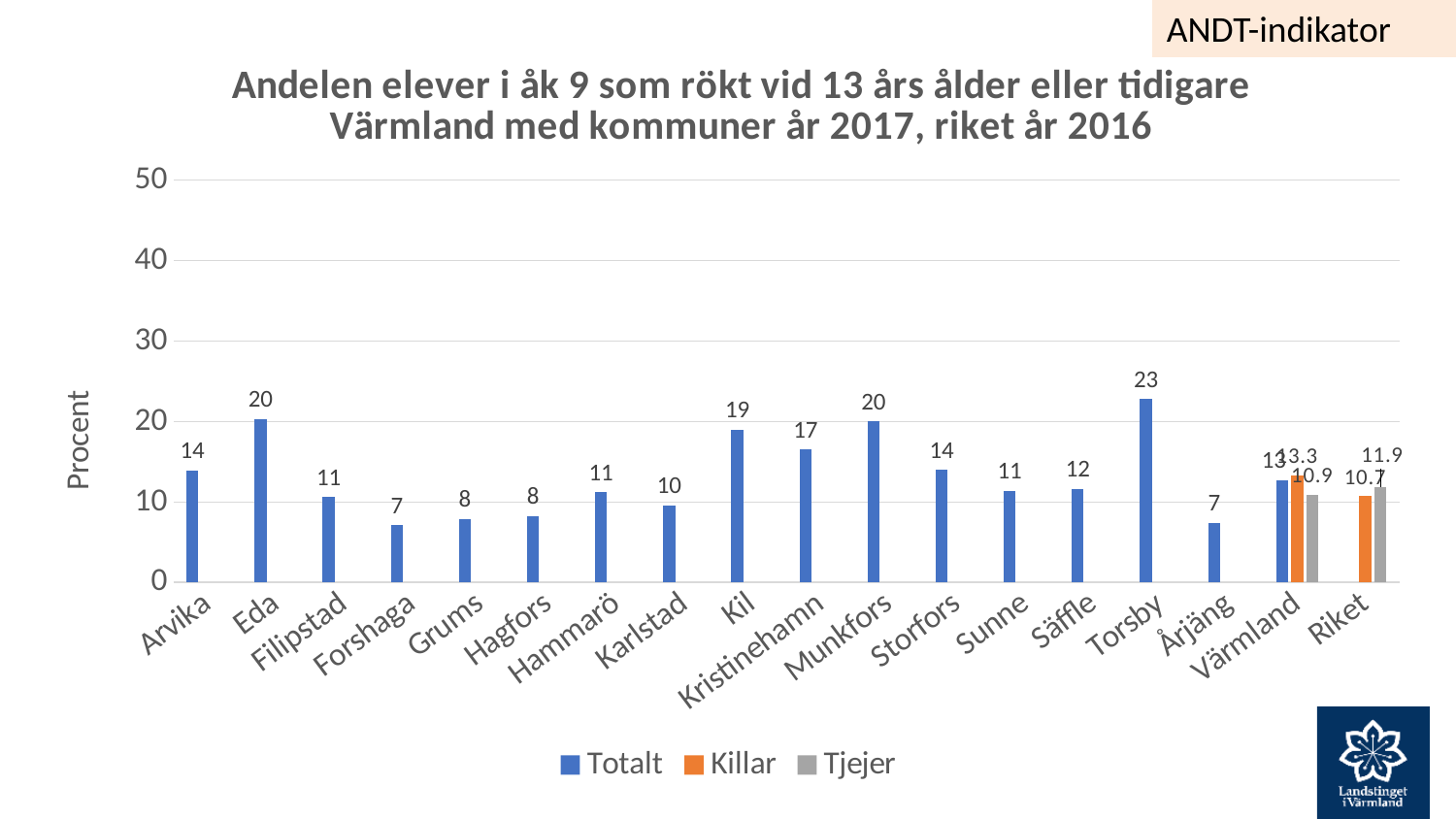
What kind of chart is shown on the slide? bar chart What is the label on the vertical axis? Procent What is the Totalt value for Kristinehamn? 17 What is the Totalt value for Torsby? 23 Which has a larger Totalt value, Kil or Kristinehamn? Kil How many series does the legend list? 3 Which category has the highest Totalt value? Torsby What is the Tjejer value for Riket? 11.9 What is the Killar value for Värmland? 13.3 Is the Totalt value for Forshaga greater or less than 10? less What is the difference between the Tjejer and Killar values for Riket? 1.2 What is the difference between the Totalt values for Torsby and Eda? 3